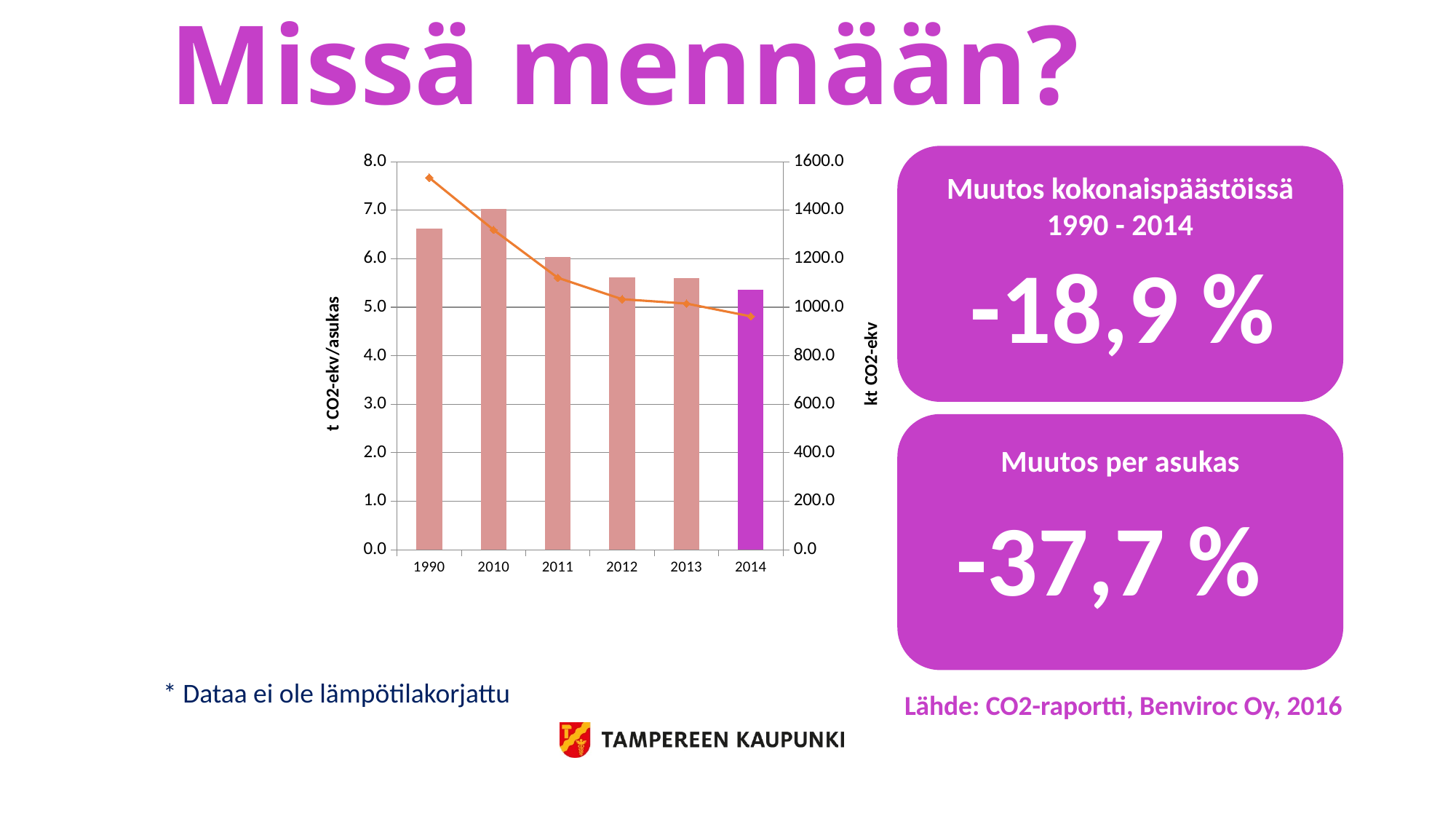
What kind of chart is shown on the slide? A bar chart combined with a line Which year has the tallest bar in the chart? 2010 How many years are shown on the x axis of the chart? 6 What is the label of the left vertical axis of the chart? t CO2-ekv/asukas Which year's bar is coloured purple instead of pink? 2014 Which year has the shortest bar in the chart? 2014 Which bar is taller, 1990 or 2010? 2010 Does the line series rise or fall from 1990 to 2014? It falls